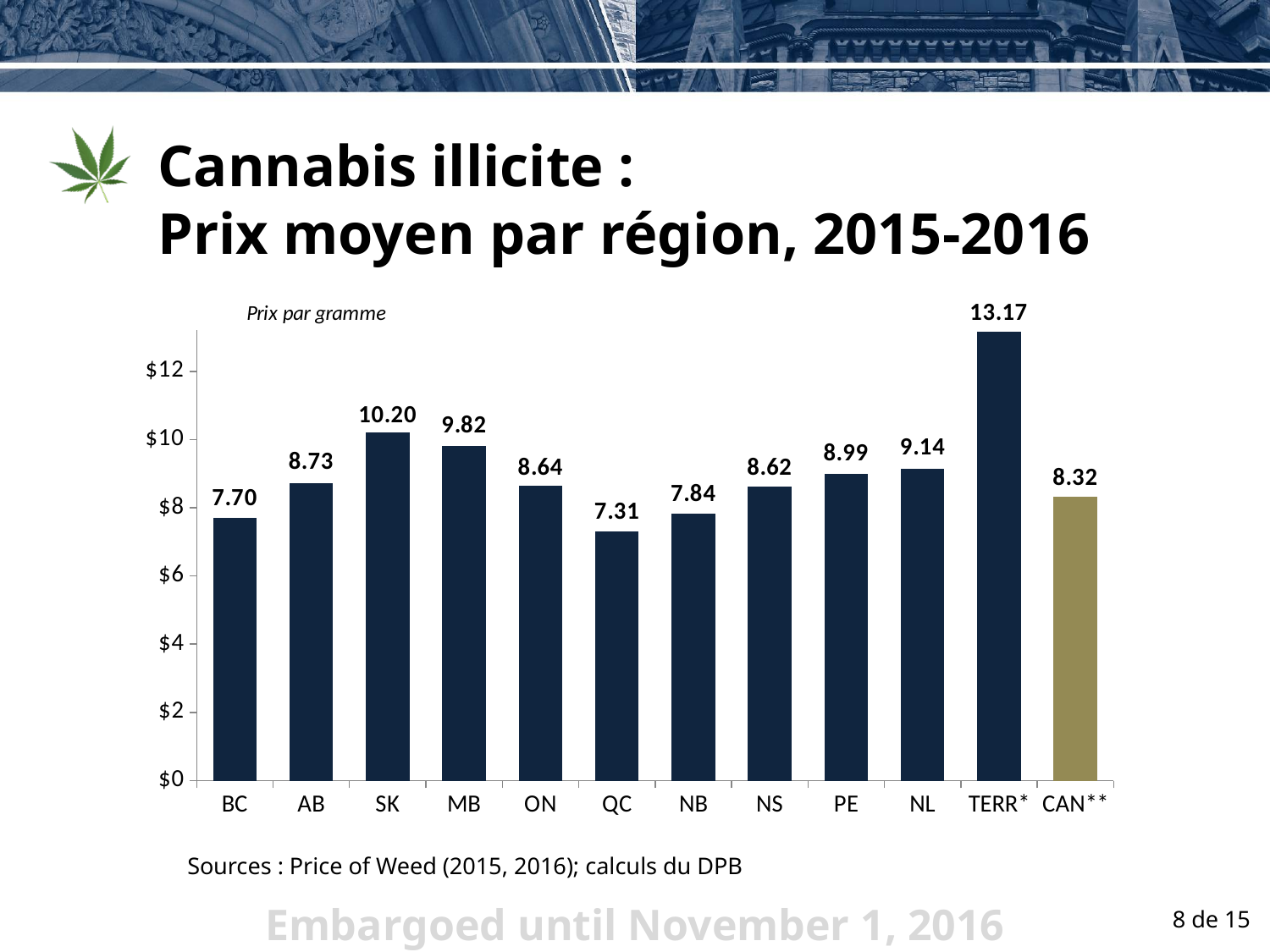
What is the value for CAN**? 8.32 Which category has the lowest value? QC Which is larger, the value for AB or the value for NL? NL Which category has the highest value? TERR* How many categories are shown on the x axis? 12 What is the label shown above the chart's y axis? Prix par gramme What is the value for SK? 10.20 What is the difference between the values for TERR* and BC? 5.47 What is the difference between the values for SK and MB? 0.38 Is the value for TERR* greater or less than $12? greater What kind of chart is shown on the slide? bar chart What is the value for QC? 7.31